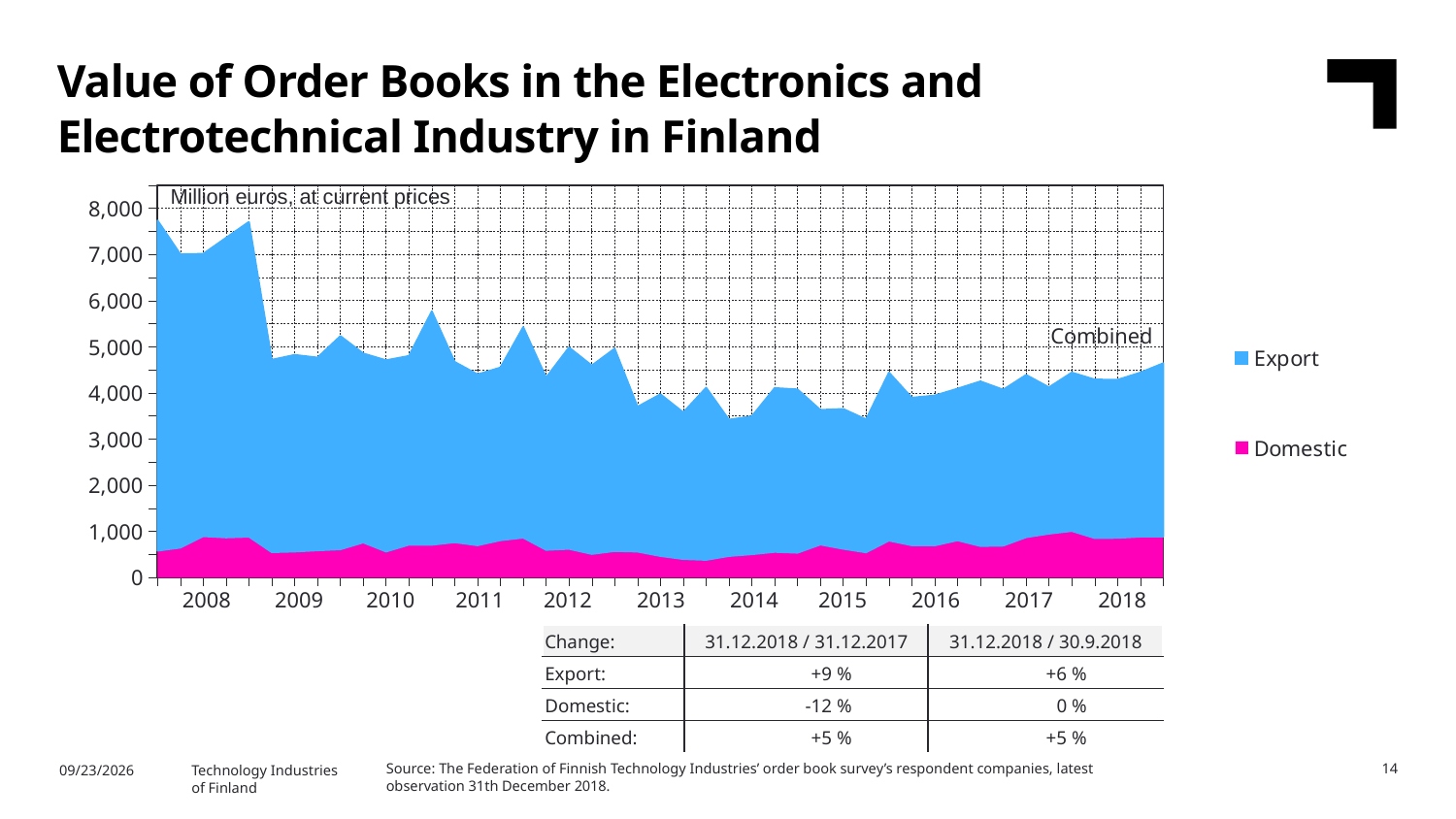
Which is larger in 2018, the Export value or the Domestic value? Export Which year shows the highest combined value of order books? 2008 What kind of chart is shown on the slide? stacked area chart Overall, does the combined value of order books rise or fall from 2008 to 2018? fall Is the combined value of order books in 2014 greater or less than 5,000? less What unit label is printed at the top of the chart area? Million euros, at current prices How many years are labelled on the x axis? 11 How many series does the legend list? 2 What are the two series named in the legend? Export and Domestic Is the combined value of order books at the start of 2008 greater or less than 7,000? greater Is the combined value of order books at the end of 2018 greater or less than 5,000? less